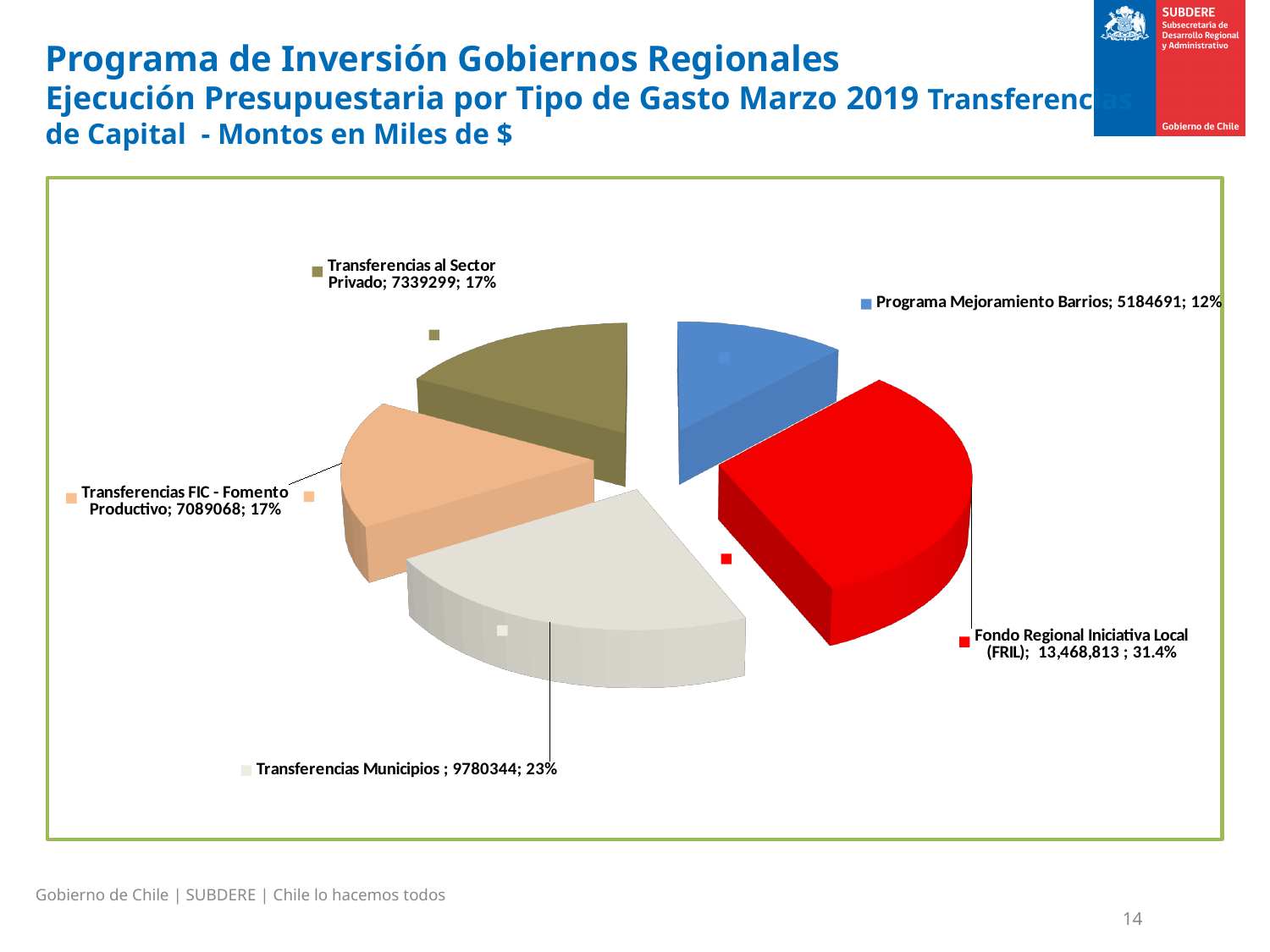
What value is shown for Fondo Regional Iniciativa Local (FRIL)? 13,468,813 What share of the pie does Transferencias Municipios represent? 23% What kind of chart is shown on the slide? Pie chart Which has the larger value, Transferencias al Sector Privado or Transferencias FIC - Fomento Productivo? Transferencias al Sector Privado What value is shown for Transferencias Municipios? 9780344 Which category has the smallest slice of the pie? Programa Mejoramiento Barrios Which category has the largest slice of the pie? Fondo Regional Iniciativa Local (FRIL) What share of the pie does Fondo Regional Iniciativa Local (FRIL) represent? 31.4% How many slices does the pie chart have? 5 What value is shown for Programa Mejoramiento Barrios? 5184691 What value is shown for Transferencias FIC - Fomento Productivo? 7089068 What is the difference between the values for Fondo Regional Iniciativa Local (FRIL) and Transferencias Municipios? 3,688,469